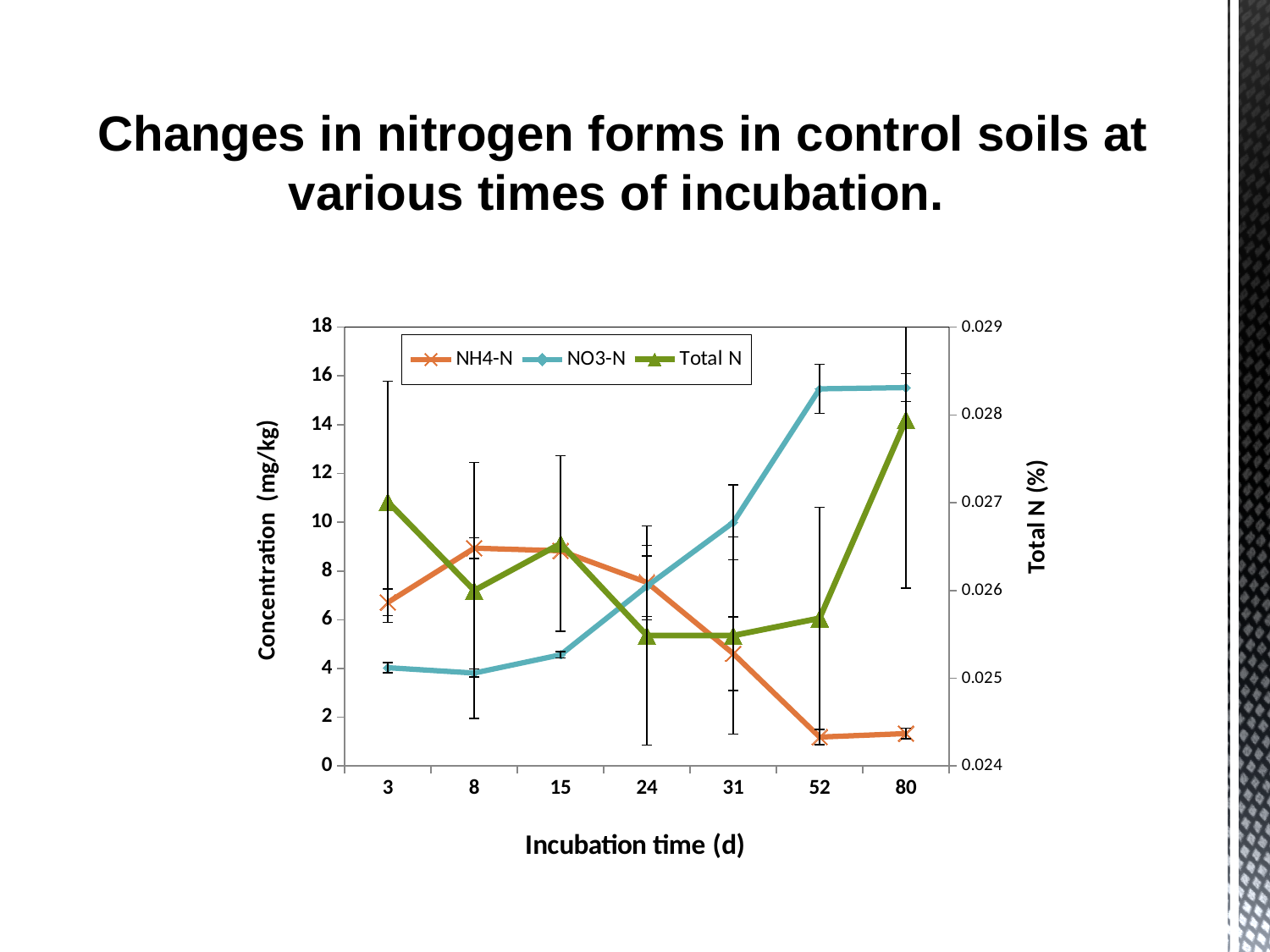
Does the NH4-N series rise or fall between day 15 and day 52? fall Is the NO3-N value at day 80 greater or less than 14 mg/kg? greater At day 80, which is larger, NH4-N or NO3-N? NO3-N What is the title of the x axis? Incubation time (d) At which incubation time is Total N highest? 80 What kind of chart is shown on the slide? line chart At day 3, which is larger, NH4-N or NO3-N? NH4-N Is the Total N value at day 80 greater or less than 0.027%? greater Does the NO3-N series generally rise or fall as incubation time increases? rise Is the NH4-N value at day 52 greater or less than 2 mg/kg? less How many series does the legend list? 3 How many incubation time points are plotted on the x axis? 7